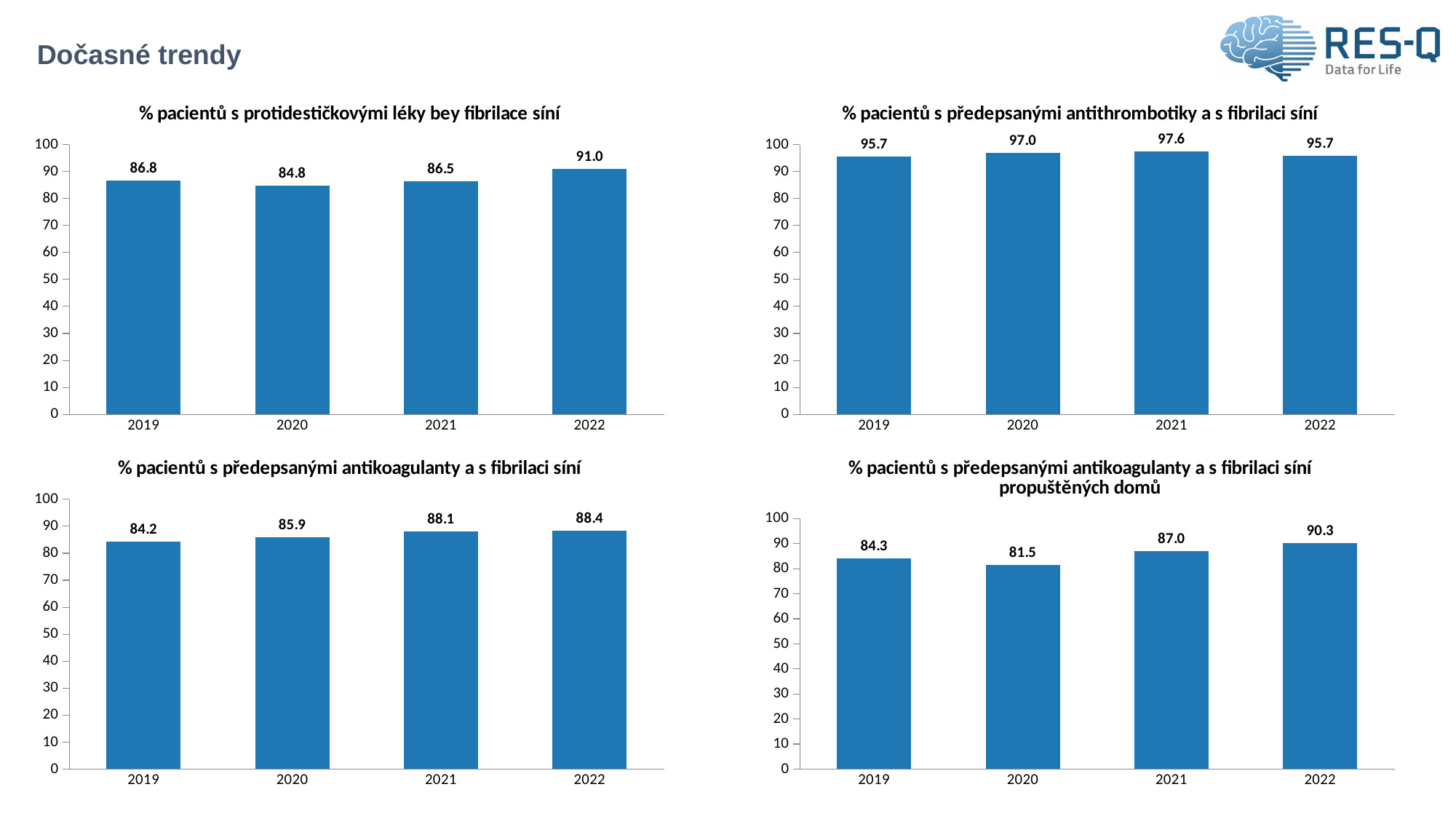
In the top-right chart (% pacientů s předepsanými antithrombotiky a s fibrilaci síní), which year has the highest value? 2021 In the bottom-left chart (% pacientů s předepsanými antikoagulanty a s fibrilaci síní), what is the difference between the 2022 and 2019 values? 4.2 In the bottom-right chart (% pacientů s předepsanými antikoagulanty a s fibrilaci síní propuštěných domů), what is the value for 2020? 81.5 In the top-left chart (% pacientů s protidestičkovými léky bey fibrilace síní), what is the value for 2022? 91.0 What is the title of the slide? Dočasné trendy In the top-right chart (% pacientů s předepsanými antithrombotiky a s fibrilaci síní), what is the value for 2020? 97.0 What kind of chart is the top-right chart (% pacientů s předepsanými antithrombotiky a s fibrilaci síní)? bar chart In the top-left chart (% pacientů s protidestičkovými léky bey fibrilace síní), which year has the lowest value? 2020 In the bottom-right chart (% pacientů s předepsanými antikoagulanty a s fibrilaci síní propuštěných domů), which is larger, the value for 2019 or 2021? 2021 In the bottom-left chart (% pacientů s předepsanými antikoagulanty a s fibrilaci síní), do the values rise or fall from 2019 to 2022? rise In the bottom-right chart (% pacientů s předepsanými antikoagulanty a s fibrilaci síní propuštěných domů), what is the difference between the 2022 and 2020 values? 8.8 How many years are shown on the x axis of the top-left chart (% pacientů s protidestičkovými léky bey fibrilace síní)? 4